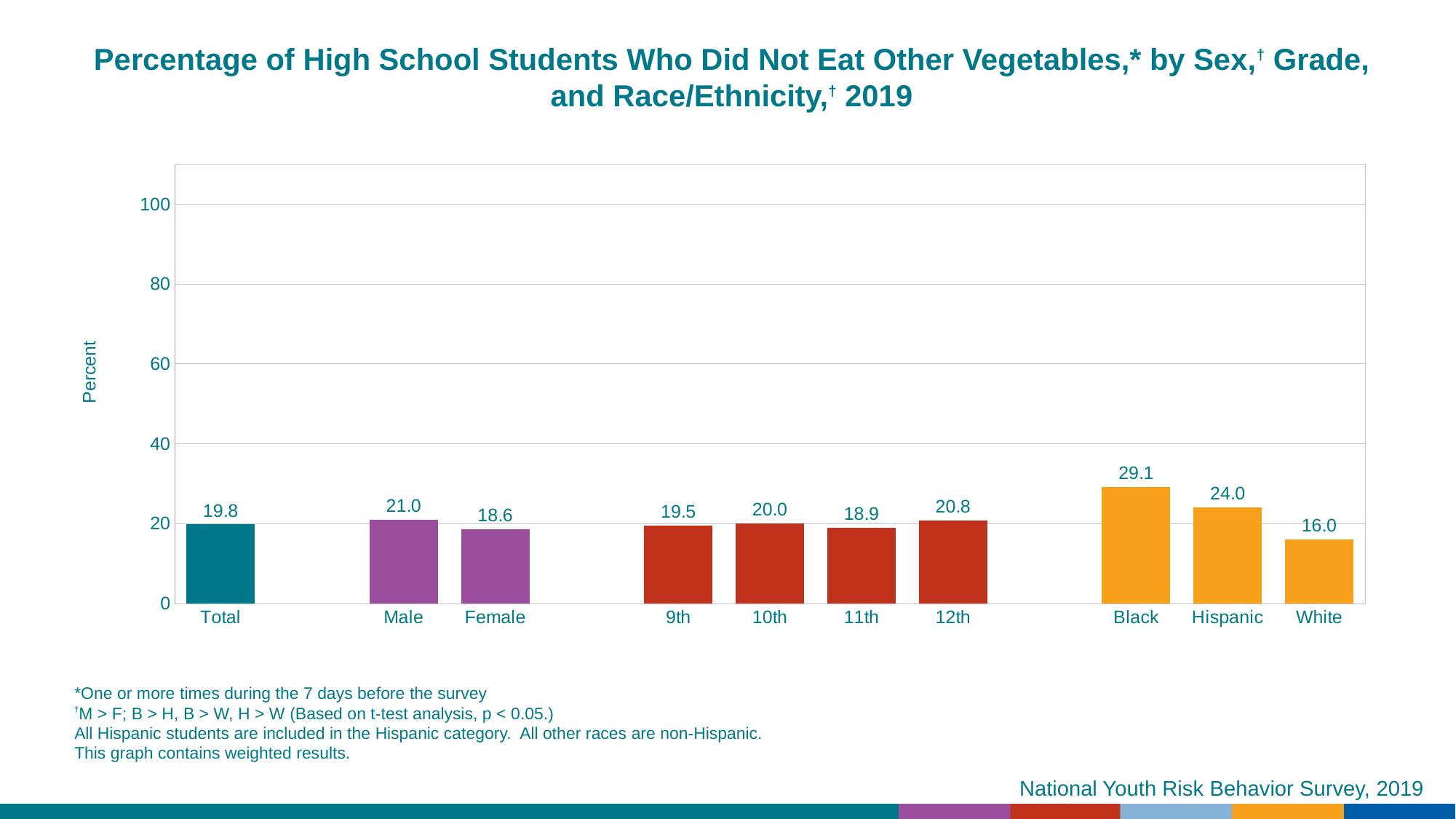
What is the value for Total? 19.8 What is the difference between the Black and Hispanic values? 5.1 Which category has the lowest value? White What kind of chart is this? bar chart Which is larger, the value for 12th grade or the value for 9th grade? 12th What is the label on the y axis? Percent What is the value for 11th grade? 18.9 Is the value for Hispanic greater or less than 20? greater How many categories are shown on the x axis? 10 What percentage of Black students did not eat other vegetables? 29.1 Which category has the highest value? Black What is the difference between the Male and Female values? 2.4